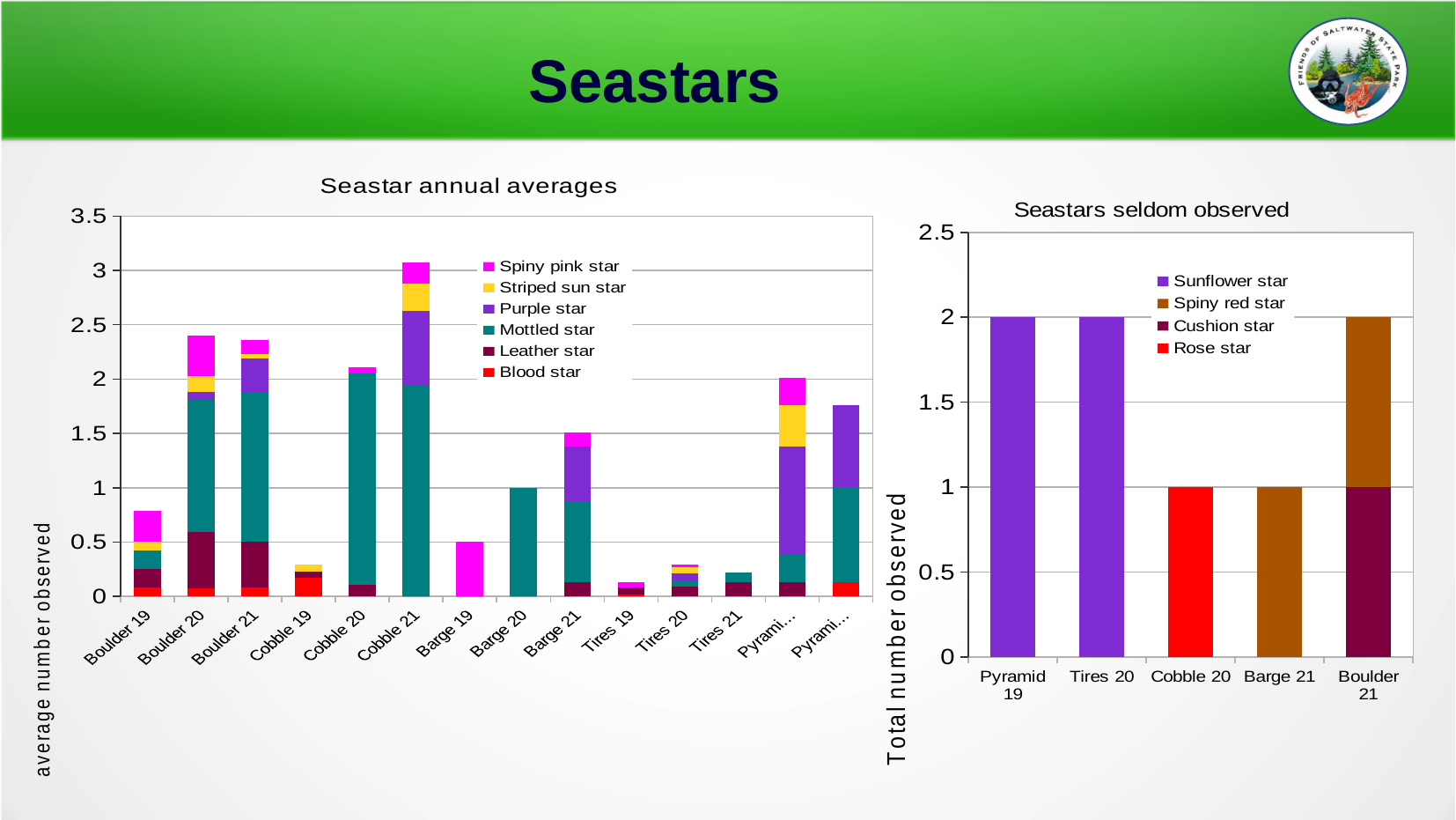
On the 'Seastar annual averages' chart, how many bars are shown along the x axis? 14 On the 'Seastars seldom observed' chart, what is the total number observed for Pyramid 19? 2 On the 'Seastar annual averages' chart, how many series does the legend list? 6 On the 'Seastars seldom observed' chart, how many series does the legend list? 4 On the 'Seastar annual averages' chart, is the total value for Boulder 20 greater or less than 2? greater What is the y-axis label of the 'Seastars seldom observed' chart? Total number observed On the 'Seastars seldom observed' chart, what is the value for Cobble 20? 1 On the 'Seastars seldom observed' chart, what is the total height of the stacked bar for Boulder 21? 2 On the 'Seastars seldom observed' chart, which of Tires 20 or Barge 21 has the larger value? Tires 20 What kind of chart is 'Seastars seldom observed'? bar chart On the 'Seastars seldom observed' chart, how many categories are shown on the x axis? 5 On the 'Seastar annual averages' chart, which category has the tallest stacked bar? Cobble 21